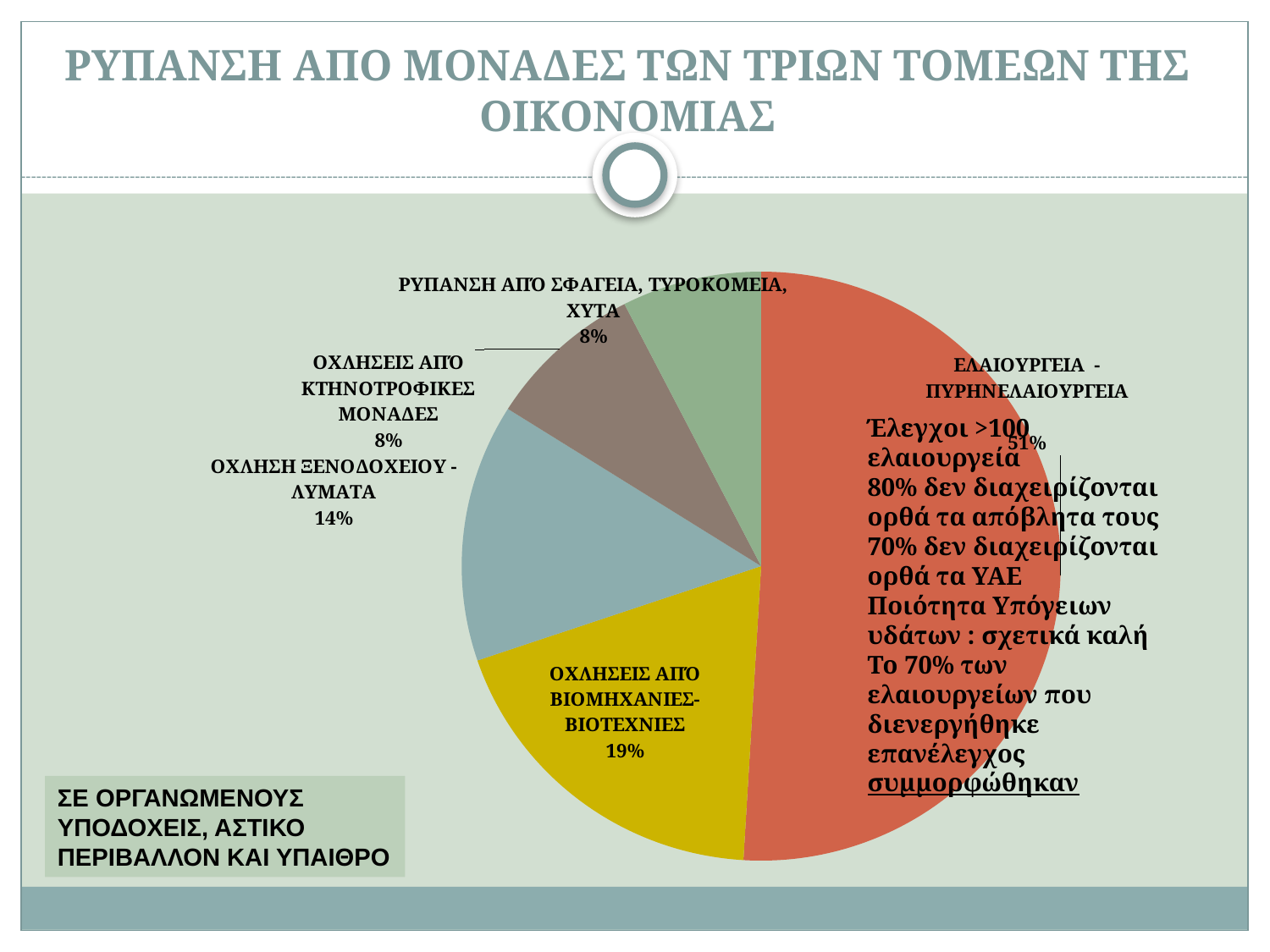
Which slice of the pie chart is the largest? ΕΛΑΙΟΥΡΓΕΙΑ - ΠΥΡΗΝΕΛΑΙΟΥΡΓΕΙΑ What share of the pie is labelled ΡΥΠΑΝΣΗ ΑΠΌ ΣΦΑΓΕΙΑ, ΤΥΡΟΚΟΜΕΙΑ, ΧΥΤΑ? 8% What share of the pie is labelled ΕΛΑΙΟΥΡΓΕΙΑ - ΠΥΡΗΝΕΛΑΙΟΥΡΓΕΙΑ? 51% What kind of chart is shown on the slide? pie chart Which is larger: the slice for ΟΧΛΗΣΕΙΣ ΑΠΌ ΒΙΟΜΗΧΑΝΙΕΣ-ΒΙΟΤΕΧΝΙΕΣ or the slice for ΟΧΛΗΣΗ ΞΕΝΟΔΟΧΕΙΟΥ - ΛΥΜΑΤΑ? ΟΧΛΗΣΕΙΣ ΑΠΌ ΒΙΟΜΗΧΑΝΙΕΣ-ΒΙΟΤΕΧΝΙΕΣ What colour is the largest slice of the pie chart? red What share of the pie is labelled ΟΧΛΗΣΕΙΣ ΑΠΌ ΒΙΟΜΗΧΑΝΙΕΣ-ΒΙΟΤΕΧΝΙΕΣ? 19% What is the difference in percentage points between the ΕΛΑΙΟΥΡΓΕΙΑ - ΠΥΡΗΝΕΛΑΙΟΥΡΓΕΙΑ slice and the ΟΧΛΗΣΕΙΣ ΑΠΌ ΒΙΟΜΗΧΑΝΙΕΣ-ΒΙΟΤΕΧΝΙΕΣ slice? 32% What is the difference in percentage points between the ΟΧΛΗΣΗ ΞΕΝΟΔΟΧΕΙΟΥ - ΛΥΜΑΤΑ slice and the ΟΧΛΗΣΕΙΣ ΑΠΌ ΚΤΗΝΟΤΡΟΦΙΚΕΣ ΜΟΝΑΔΕΣ slice? 6% How many slices does the pie chart have? 5 What share of the pie is labelled ΟΧΛΗΣΗ ΞΕΝΟΔΟΧΕΙΟΥ - ΛΥΜΑΤΑ? 14% What share of the pie is labelled ΟΧΛΗΣΕΙΣ ΑΠΌ ΚΤΗΝΟΤΡΟΦΙΚΕΣ ΜΟΝΑΔΕΣ? 8%